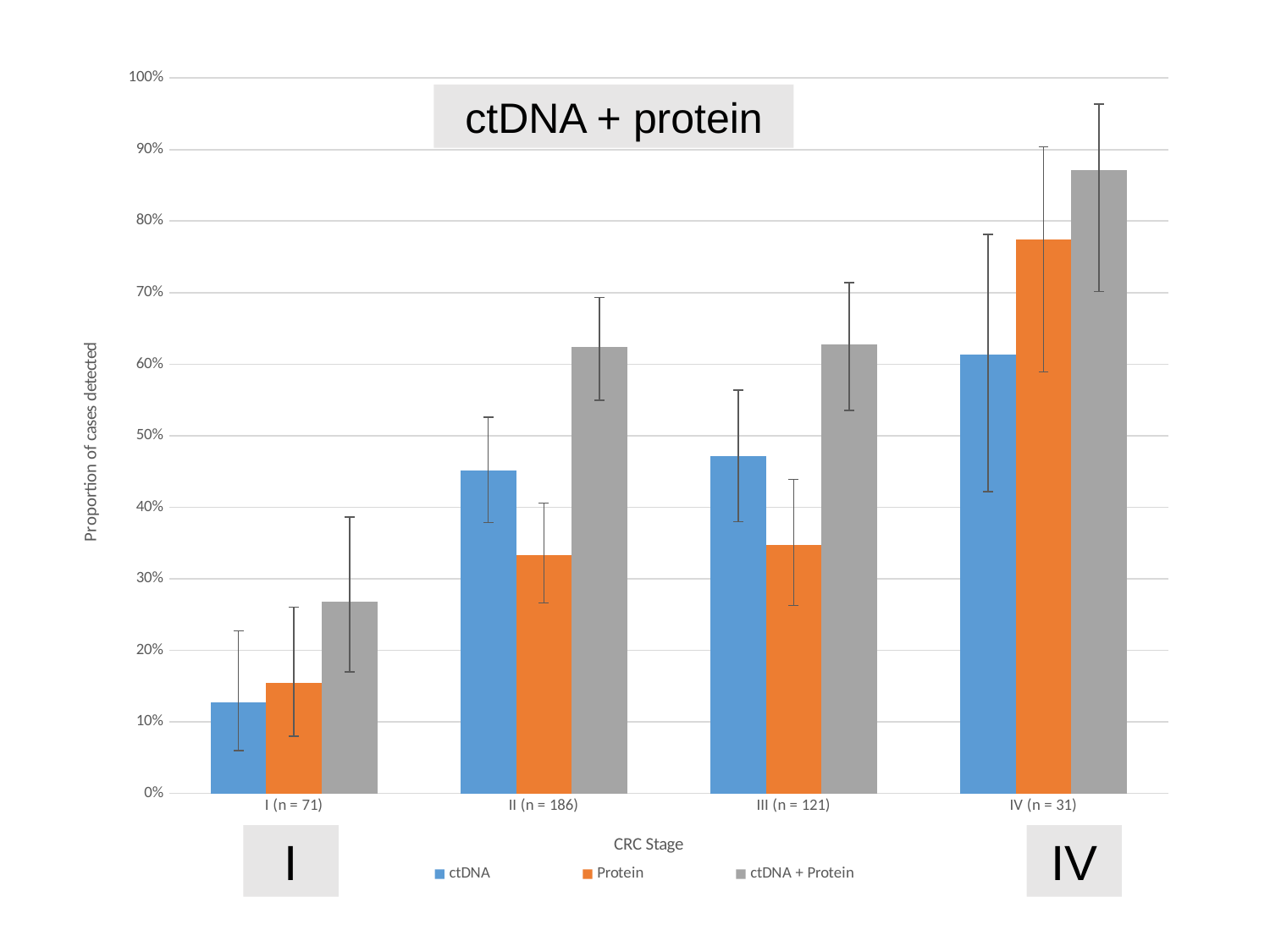
Is the ctDNA + Protein value for stage IV (n = 31) greater or less than 80%? greater Is the Protein value for stage II (n = 186) greater or less than 40%? less What kind of chart is shown on the slide? bar chart Is the ctDNA value for stage I (n = 71) greater or less than 20%? less At stage II (n = 186), which is larger: ctDNA or Protein? ctDNA How many CRC stage categories are shown on the x axis? 4 How many series does the legend list? 3 Which CRC stage has the lowest ctDNA value? I (n = 71) At stage IV (n = 31), which is larger: ctDNA or Protein? Protein Which CRC stage has the highest ctDNA + Protein value? IV (n = 31) Do the ctDNA + Protein values rise or fall from stage I to stage IV? rise